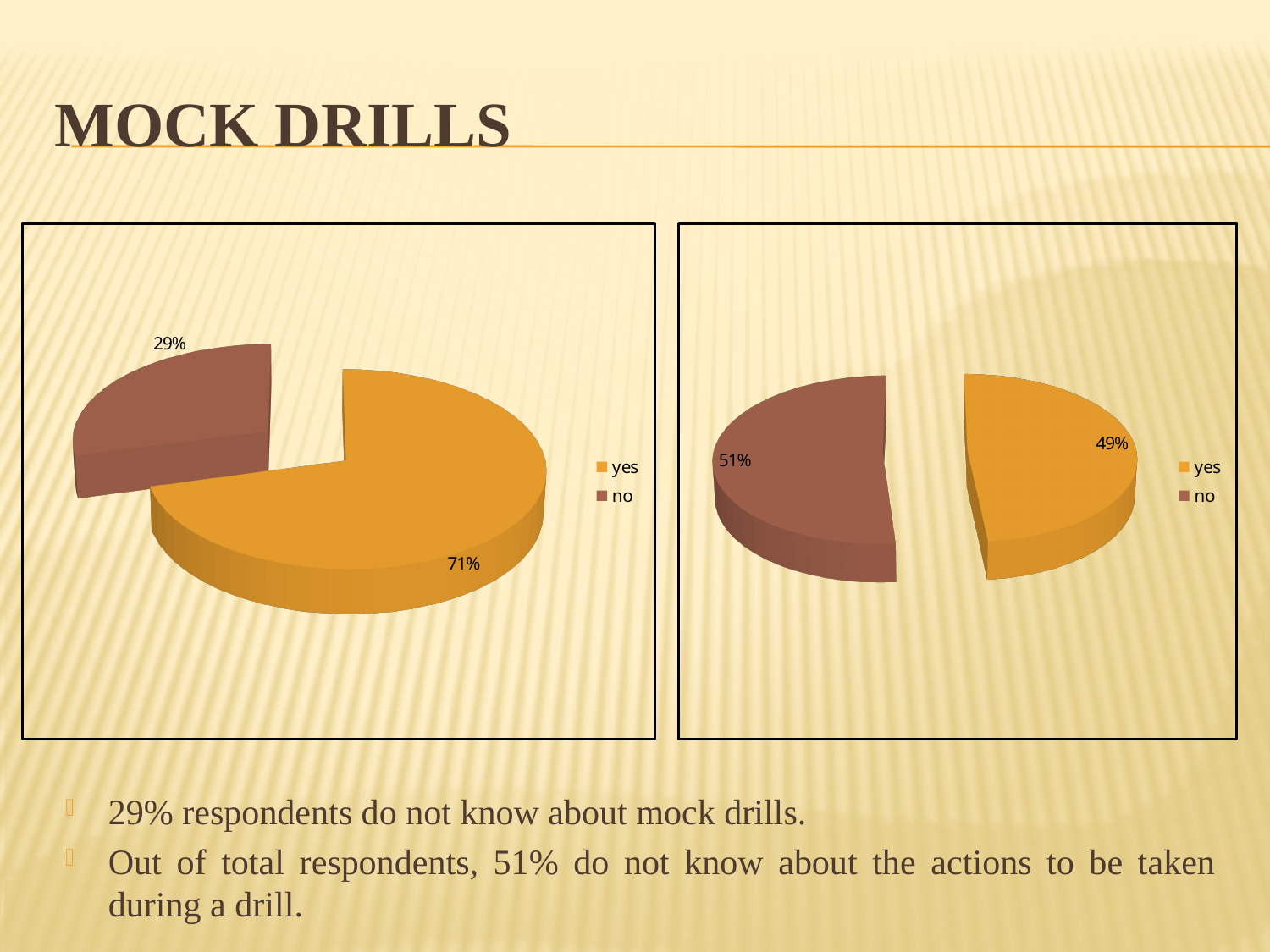
In the left pie chart, which slice is the largest? yes In the left pie chart, what share is labelled for "yes"? 71% In the right pie chart, what share is labelled for "no"? 51% What kind of chart is the left chart? pie chart In the left pie chart, what is the difference between the "yes" and "no" shares? 42% In the right pie chart, which colour represents "no"? brown How many slices does the right pie chart have? 2 In the left pie chart, what share is labelled for "no"? 29% In the left pie chart, which slice is the smallest? no In the right pie chart, what is the difference between the "no" and "yes" shares? 2% In the right pie chart, what share is labelled for "yes"? 49% How many entries does the legend of the left pie chart list? 2